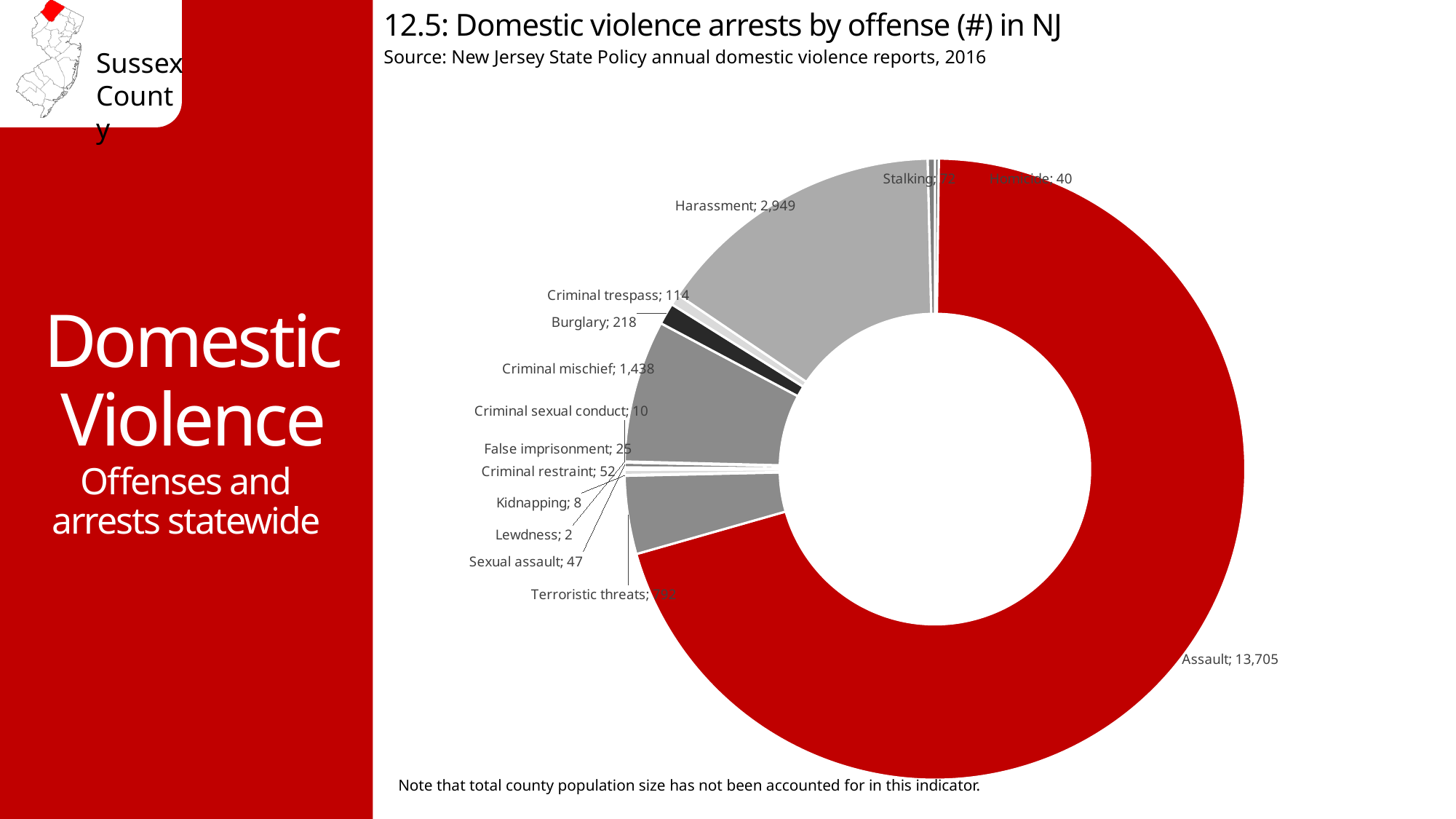
What is the value for Homicide? 40 Which offense has the highest number of arrests? Assault What is the difference between the Harassment and Criminal mischief values? 1,511 How many domestic violence arrests for Assault are shown? 13,705 What is the value for Burglary? 218 Which is larger, the value for Burglary or the value for Criminal trespass? Burglary What is the value for Harassment? 2,949 Which offense has the lowest number of arrests? Lewdness What is the value for Lewdness? 2 What kind of chart is shown on the slide? Doughnut (pie) chart What is the value for Criminal mischief? 1,438 How many offense categories are shown in the chart? 14